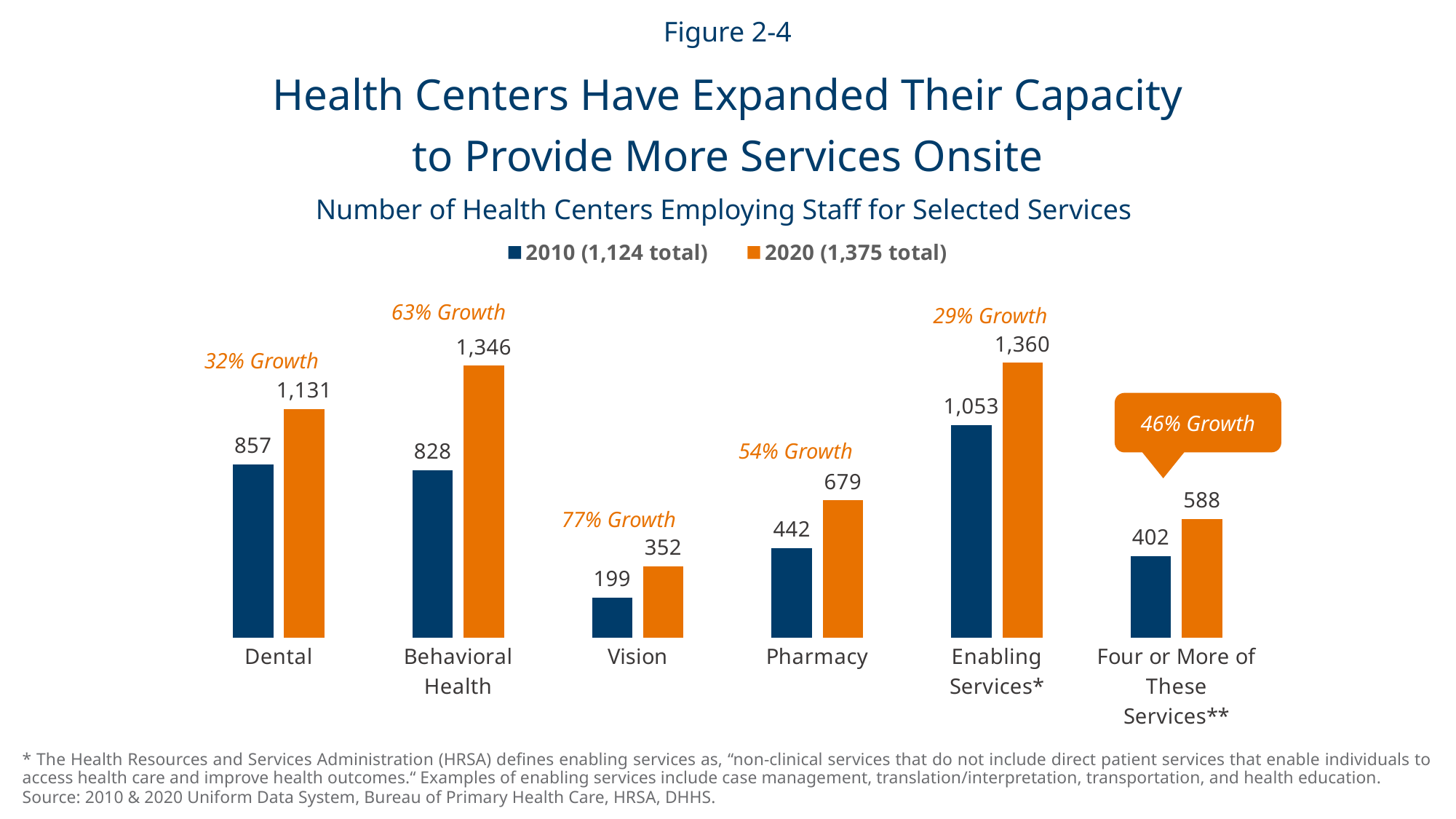
How many service categories are shown on the x axis? 6 How many series does the legend list? 2 What is the 2010 value for Vision? 199 What growth percentage is shown for Vision? 77% Growth Which category has the lowest 2010 value? Vision Which category has the highest 2020 value? Enabling Services What is the 2010 value for Enabling Services? 1,053 What total is given in the legend for 2020? 1,375 total What is the 2020 value for Behavioral Health? 1,346 What is the difference between the 2020 and 2010 values for Pharmacy? 237 Which is larger: the 2020 value for Dental or the 2020 value for Behavioral Health? Behavioral Health What kind of chart is shown? Bar chart